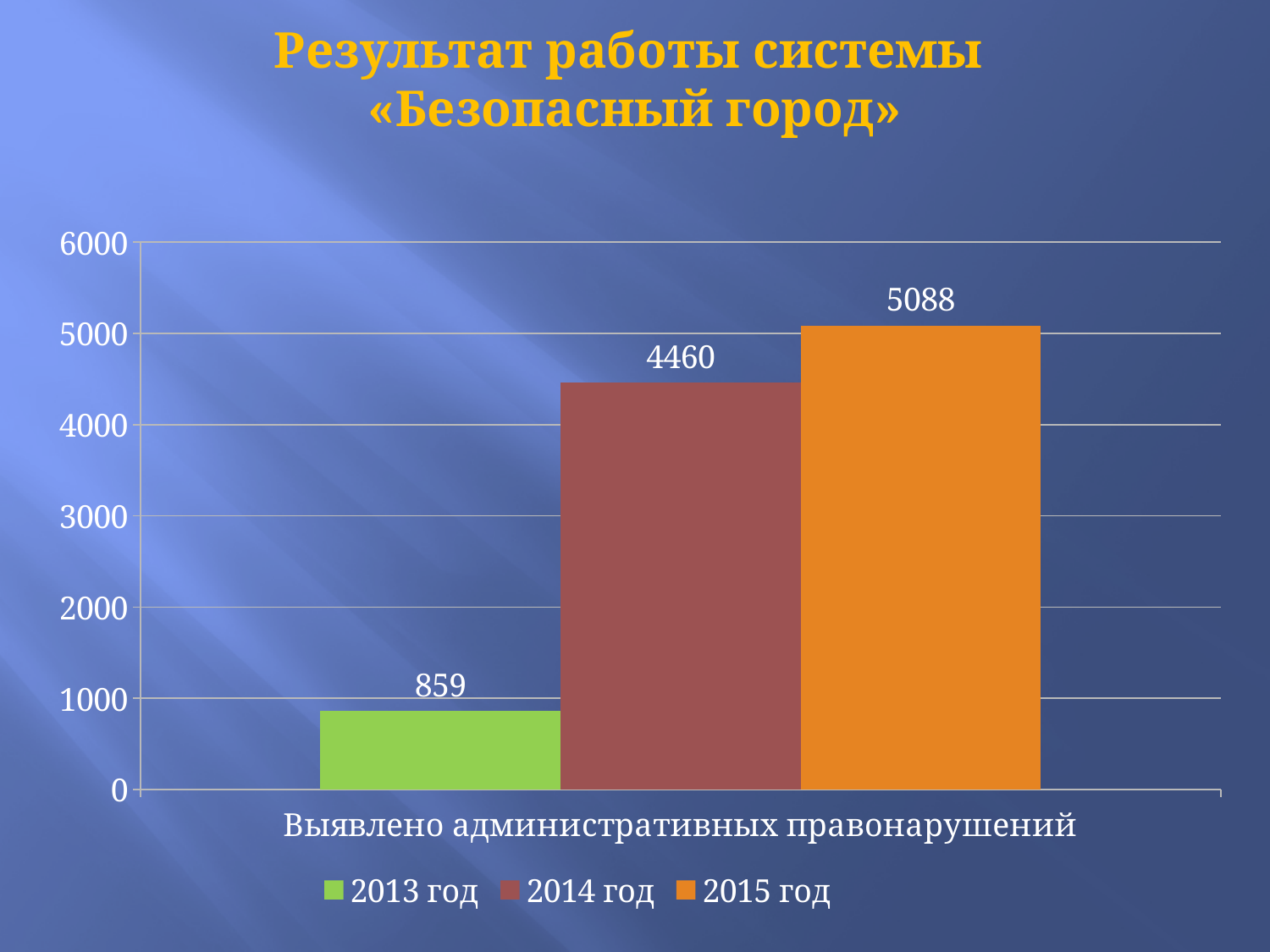
What is the value for 2014 год? 4460 Is the value for 2013 год greater or less than 1000? less What kind of chart is shown on the slide? bar chart How many series does the legend list? 3 What is the difference between the values for 2015 год and 2014 год? 628 What is the value for 2013 год? 859 Which year has the lowest value? 2013 год Which is larger, the value for 2014 год or 2015 год? 2015 год What is the difference between the values for 2014 год and 2013 год? 3601 Which year has the highest value? 2015 год What is the value for 2015 год? 5088 What is the title of the chart on the slide? Результат работы системы «Безопасный город»